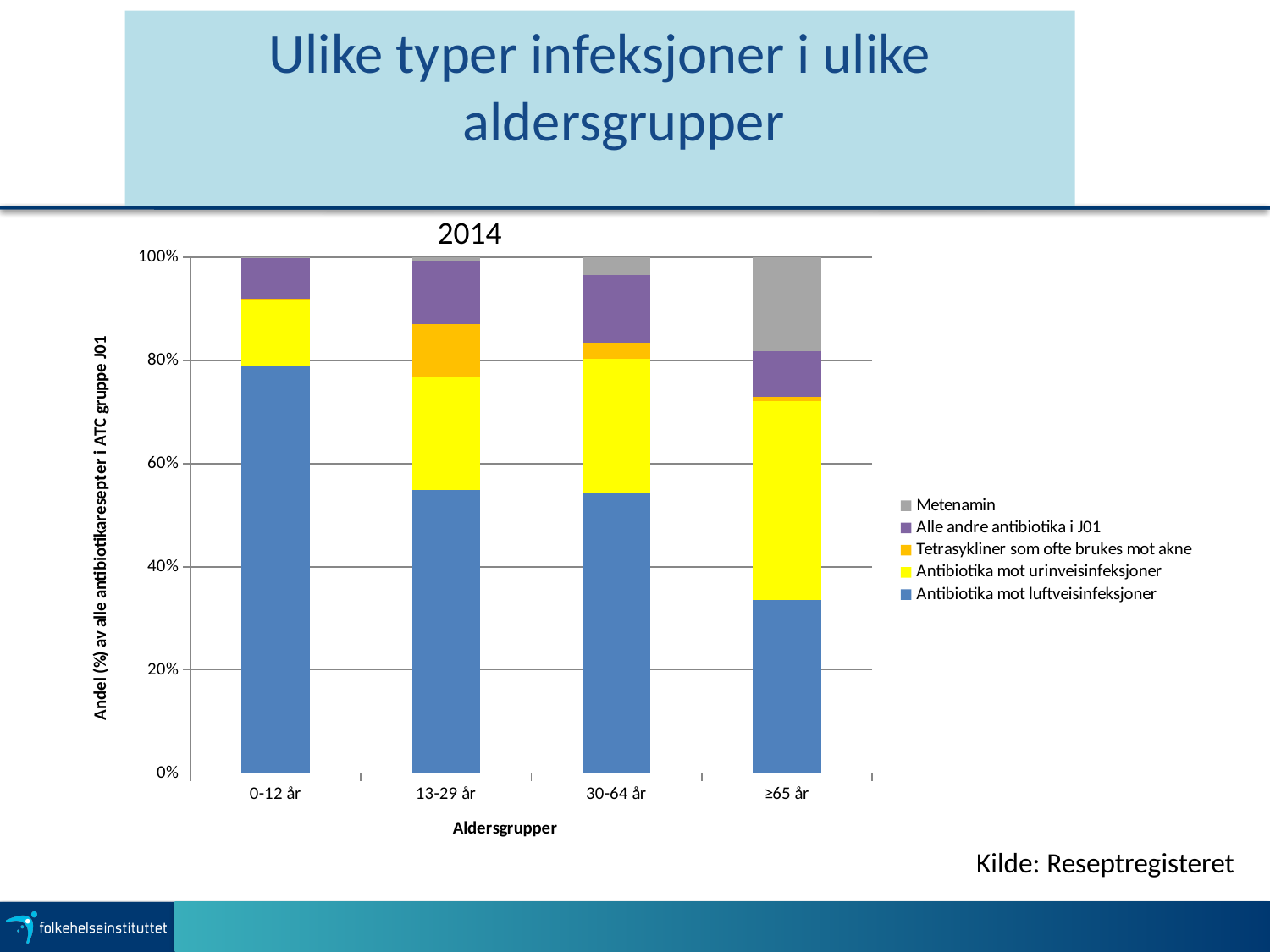
What is the title of the chart? 2014 Which age group has the smallest share of 'Antibiotika mot luftveisinfeksjoner'? ≥65 år Is the share of 'Antibiotika mot luftveisinfeksjoner' for ≥65 år greater or less than 40%? less What kind of chart is shown on the slide? Stacked bar chart Which age group has the largest share of 'Metenamin'? ≥65 år How many age groups are shown on the x axis of the chart? 4 What is the total of the stacked bar for 13-29 år? 100% Which age group has a larger share of 'Antibiotika mot urinveisinfeksjoner', 0-12 år or ≥65 år? ≥65 år What is the x-axis title of the chart? Aldersgrupper Which age group has the largest share of 'Antibiotika mot luftveisinfeksjoner'? 0-12 år Is the share of 'Antibiotika mot luftveisinfeksjoner' for 0-12 år greater or less than 60%? greater How many series does the chart's legend list? 5